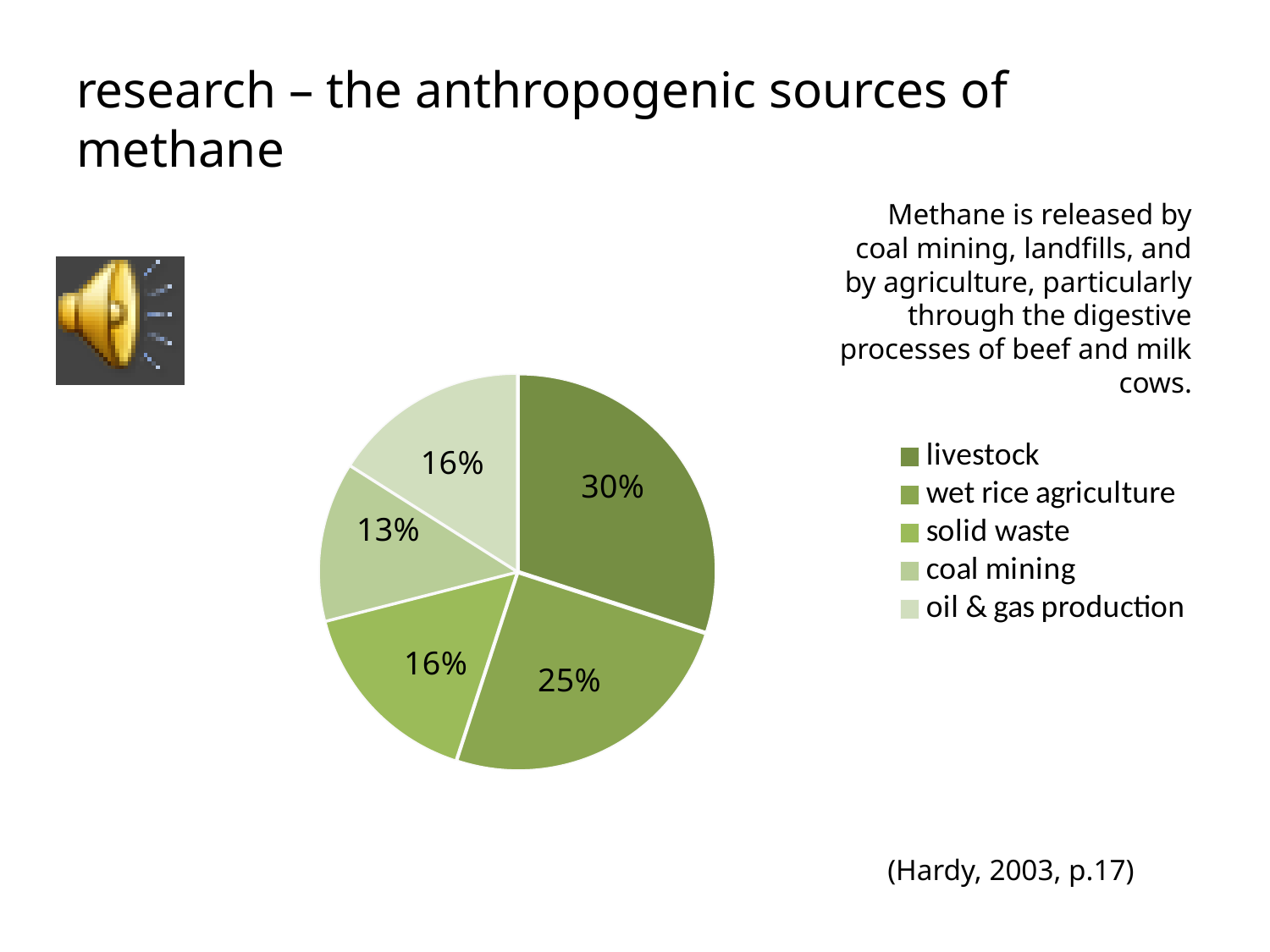
Which source has the smallest slice of the pie? coal mining What share of the pie does wet rice agriculture account for? 25% What share of the pie does solid waste account for? 16% Which source has the largest slice of the pie? livestock How many sources are shown in the pie chart? 5 What kind of chart is shown on the slide? pie chart What share of the pie does livestock account for? 30% Which is larger, the share for wet rice agriculture or the share for oil & gas production? wet rice agriculture What is the difference in percentage points between livestock and wet rice agriculture? 5 What is the difference in percentage points between solid waste and coal mining? 3 What share of the pie does coal mining account for? 13% Which legend entry is listed last? oil & gas production